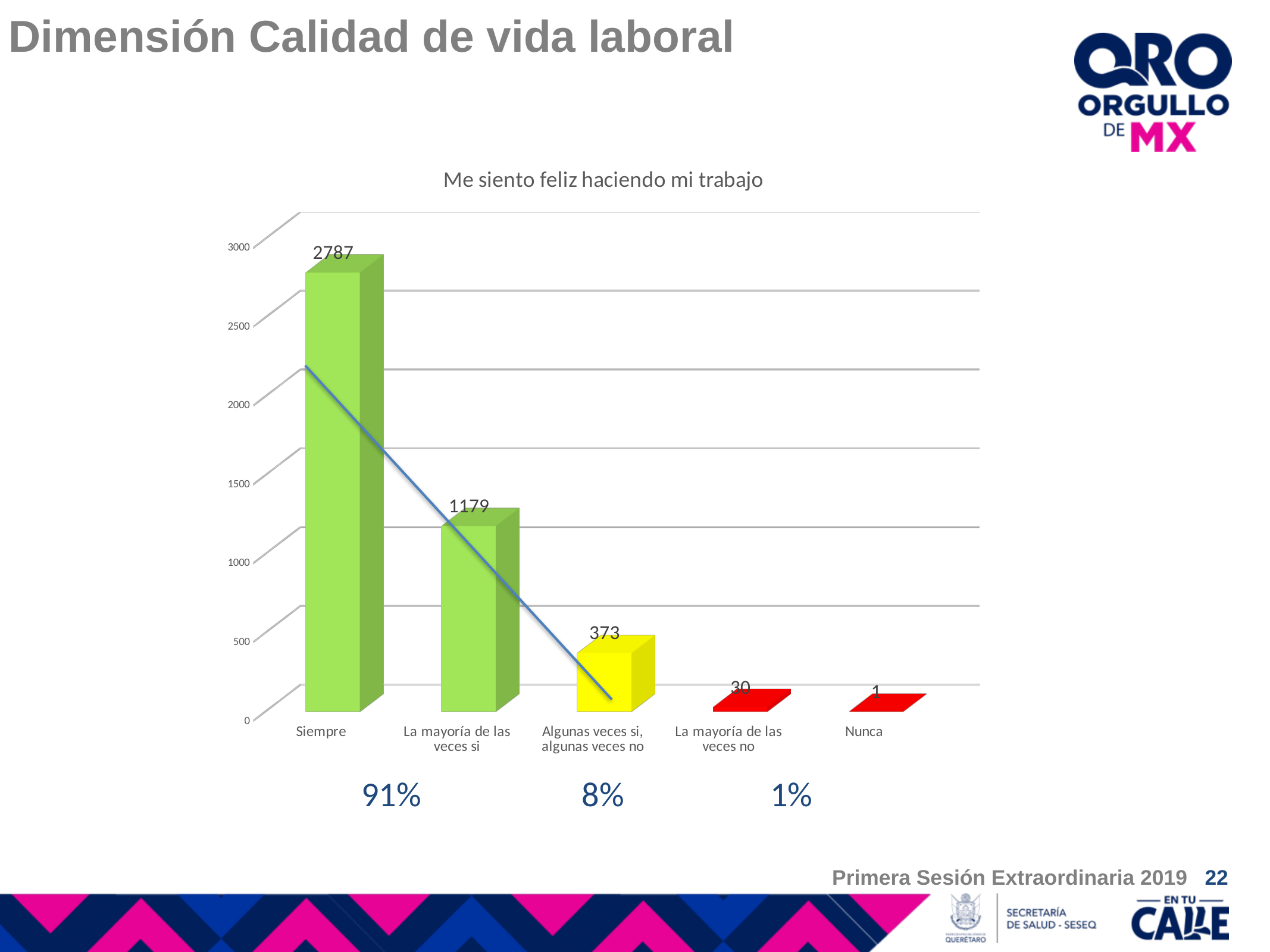
What is the value for "La mayoría de las veces si"? 1179 What is the title of the chart? Me siento feliz haciendo mi trabajo What is the value for "Siempre"? 2787 Which category has the highest value? Siempre What is the difference between the values for "Siempre" and "La mayoría de las veces si"? 1608 Is the value for "La mayoría de las veces si" greater or less than 1000? greater Which is larger, the value for "Algunas veces si, algunas veces no" or the value for "La mayoría de las veces no"? Algunas veces si, algunas veces no What is the value for "Algunas veces si, algunas veces no"? 373 What is the value for "Nunca"? 1 Which category has the lowest value? Nunca What kind of chart is shown? bar chart How many categories are shown on the x axis? 5